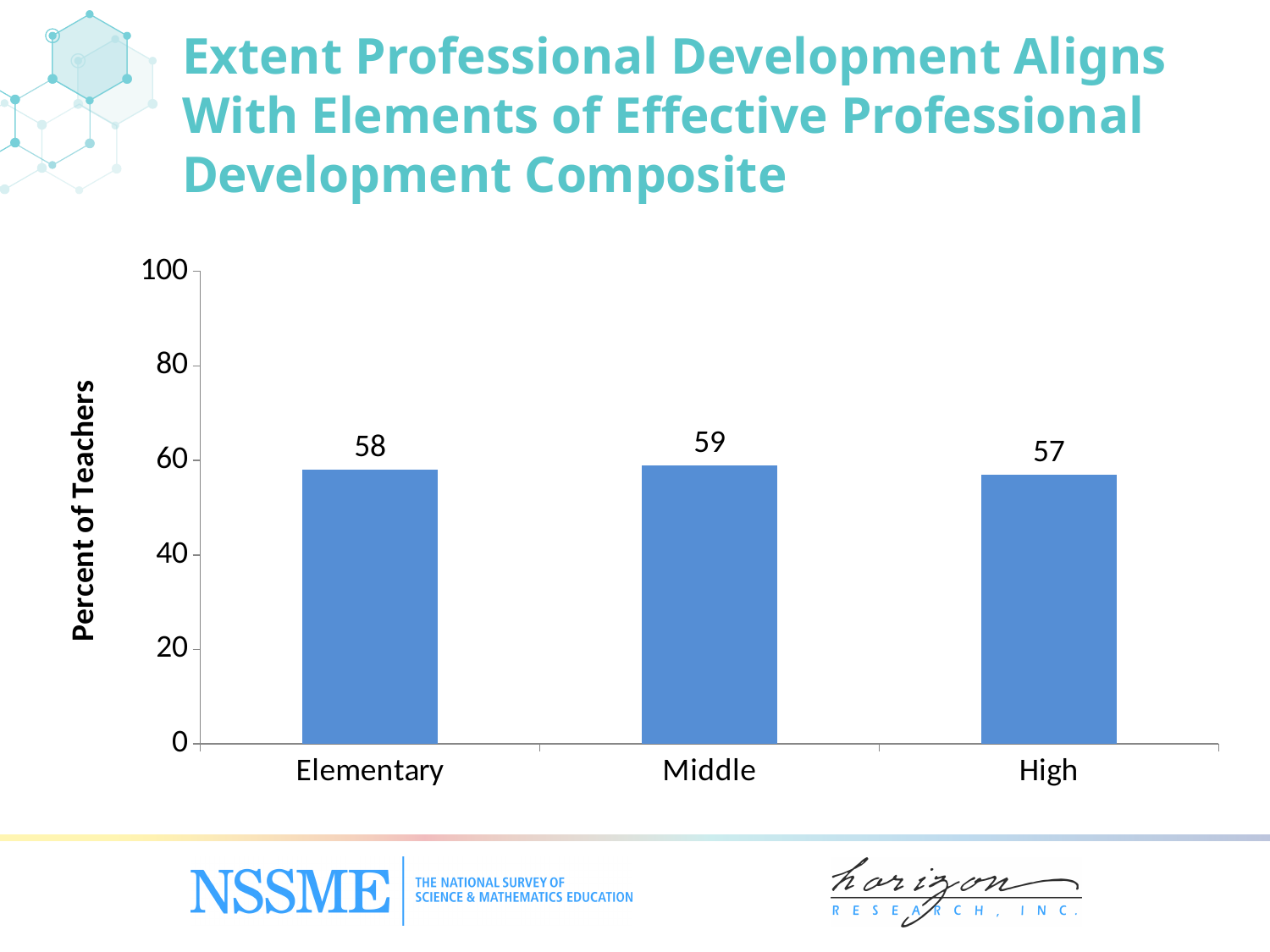
What is the label of the y axis? Percent of Teachers What is the value for Middle? 59 What is the value for Elementary? 58 What is the difference between the values for Middle and High? 2 Is the value for Elementary greater or less than 80? less Which category has the lowest value according to the data labels? High What is the value for High? 57 What kind of chart is shown on the slide? bar chart Which category has the highest value according to the data labels? Middle What is the difference between the values for Elementary and High? 1 Is the value for High greater or less than 40? greater How many categories are shown on the x axis? 3